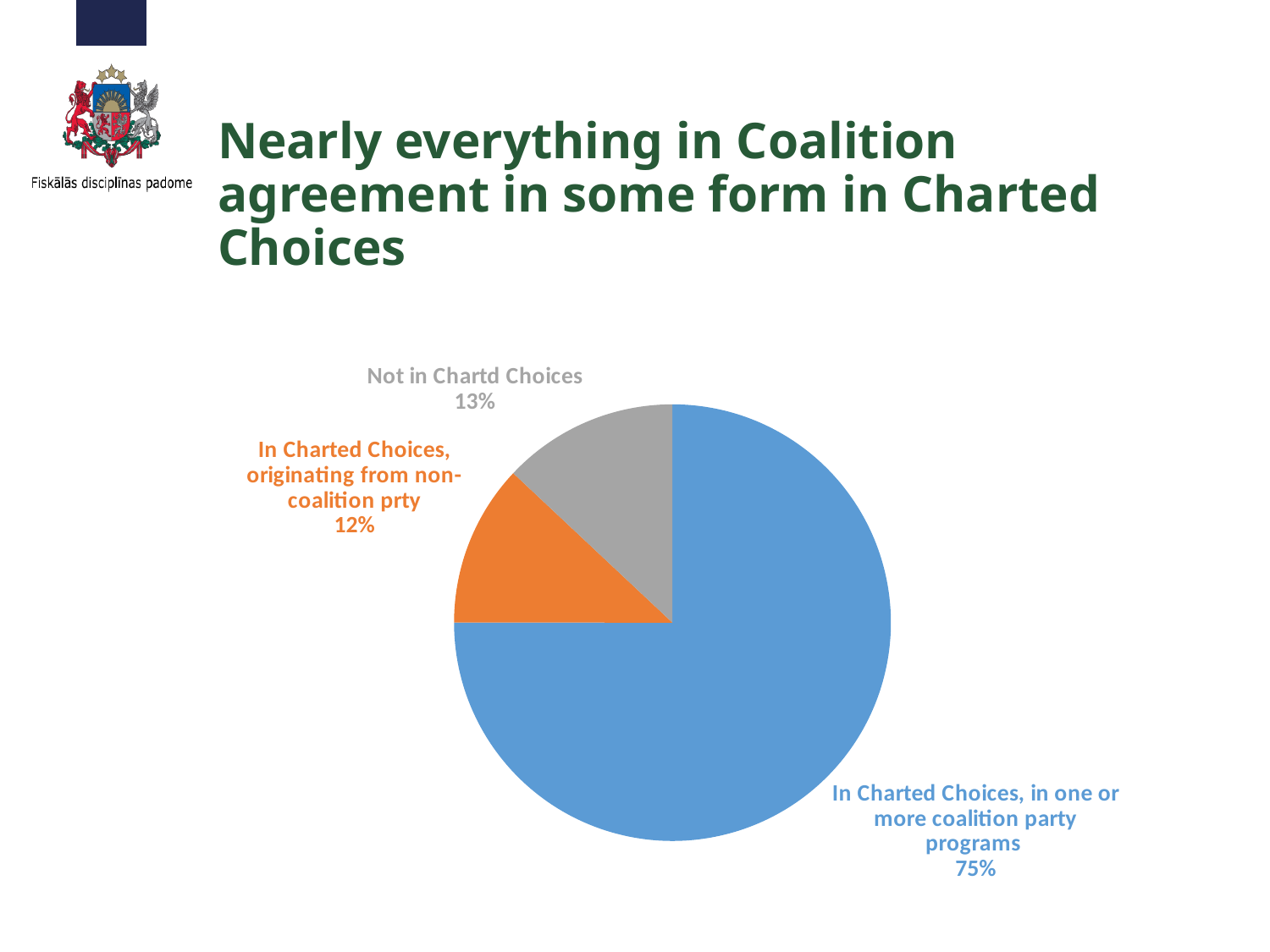
What kind of chart is shown on the slide? Pie chart How many slices does the pie chart have? 3 Which is larger: the "Not in Chartd Choices" slice or the "In Charted Choices, in one or more coalition party programs" slice? In Charted Choices, in one or more coalition party programs What is the difference in percentage points between the "In Charted Choices, in one or more coalition party programs" slice and the "Not in Chartd Choices" slice? 62 percentage points Which slice of the pie is the largest? In Charted Choices, in one or more coalition party programs What is the difference in percentage points between the "Not in Chartd Choices" slice and the "In Charted Choices, originating from non-coalition prty" slice? 1 percentage point What share of the pie is labelled "In Charted Choices, originating from non-coalition prty"? 12% What colour is the "In Charted Choices, originating from non-coalition prty" slice? Orange Which slice of the pie is the smallest? In Charted Choices, originating from non-coalition prty What share of the pie is labelled "Not in Chartd Choices"? 13% What share of the pie is labelled "In Charted Choices, in one or more coalition party programs"? 75% What colour is the "Not in Chartd Choices" slice? Grey